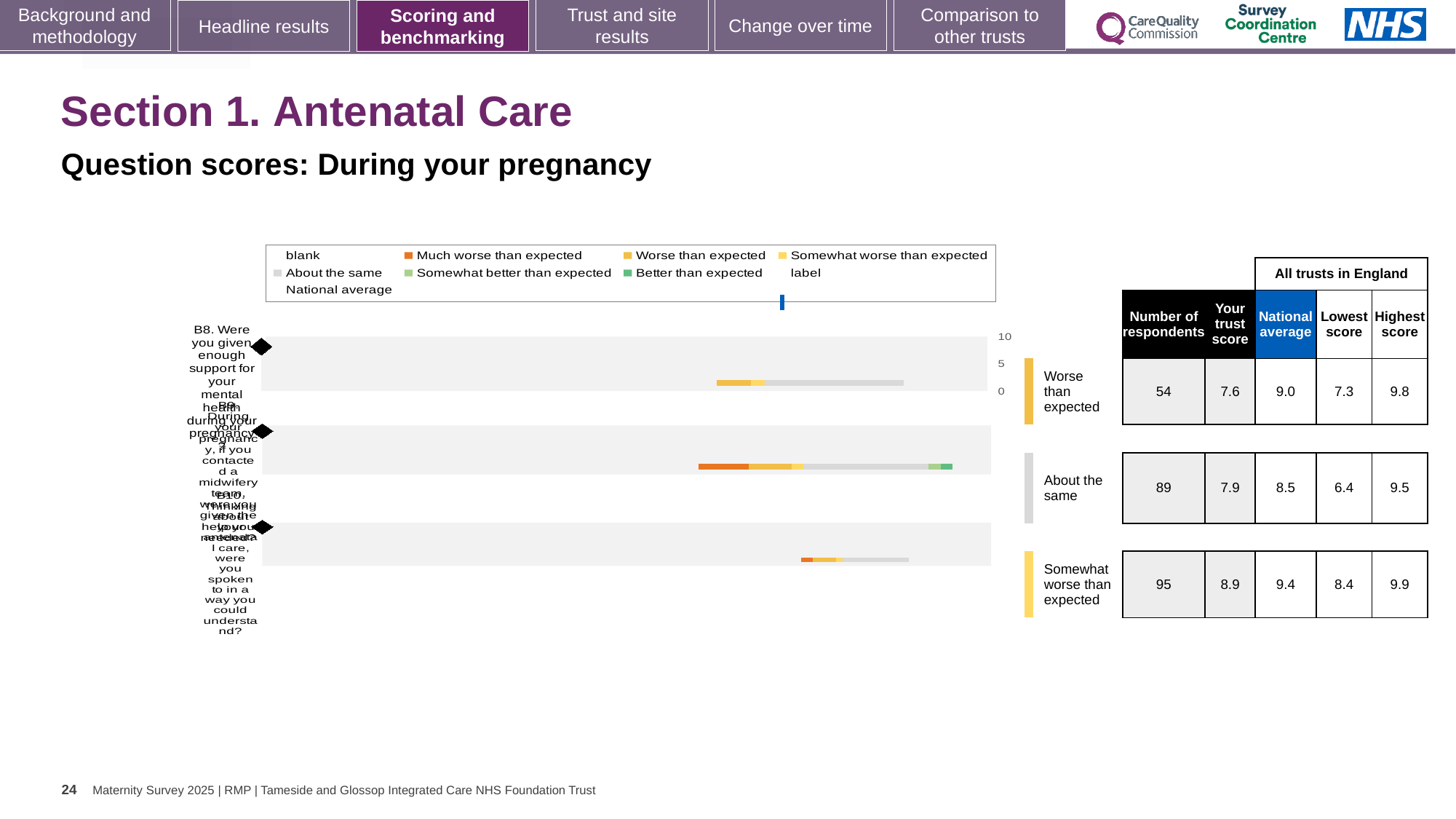
What is the highest score among all trusts in England for the first question row (B8)? 9.8 For the second question row, which is larger: the trust score or the national average? national average Which question row has the lowest trust score? the first row (B8), 7.6 What kind of chart is used to show the question scores on this slide? bar chart What is the maximum value shown on the chart's score axis? 10 How many question rows are plotted in the chart? 3 What is the number of respondents for the first question row (B8, support for your mental health during pregnancy)? 54 What benchmark category is shown for the first question row (B8)? Worse than expected Which question row has the highest number of respondents? the third row (95 respondents) What is the trust score for the first question row (B8)? 7.6 What is the national average for the first question row (B8)? 9.0 What is the difference between the national average and the trust score for the first question row (B8)? 1.4